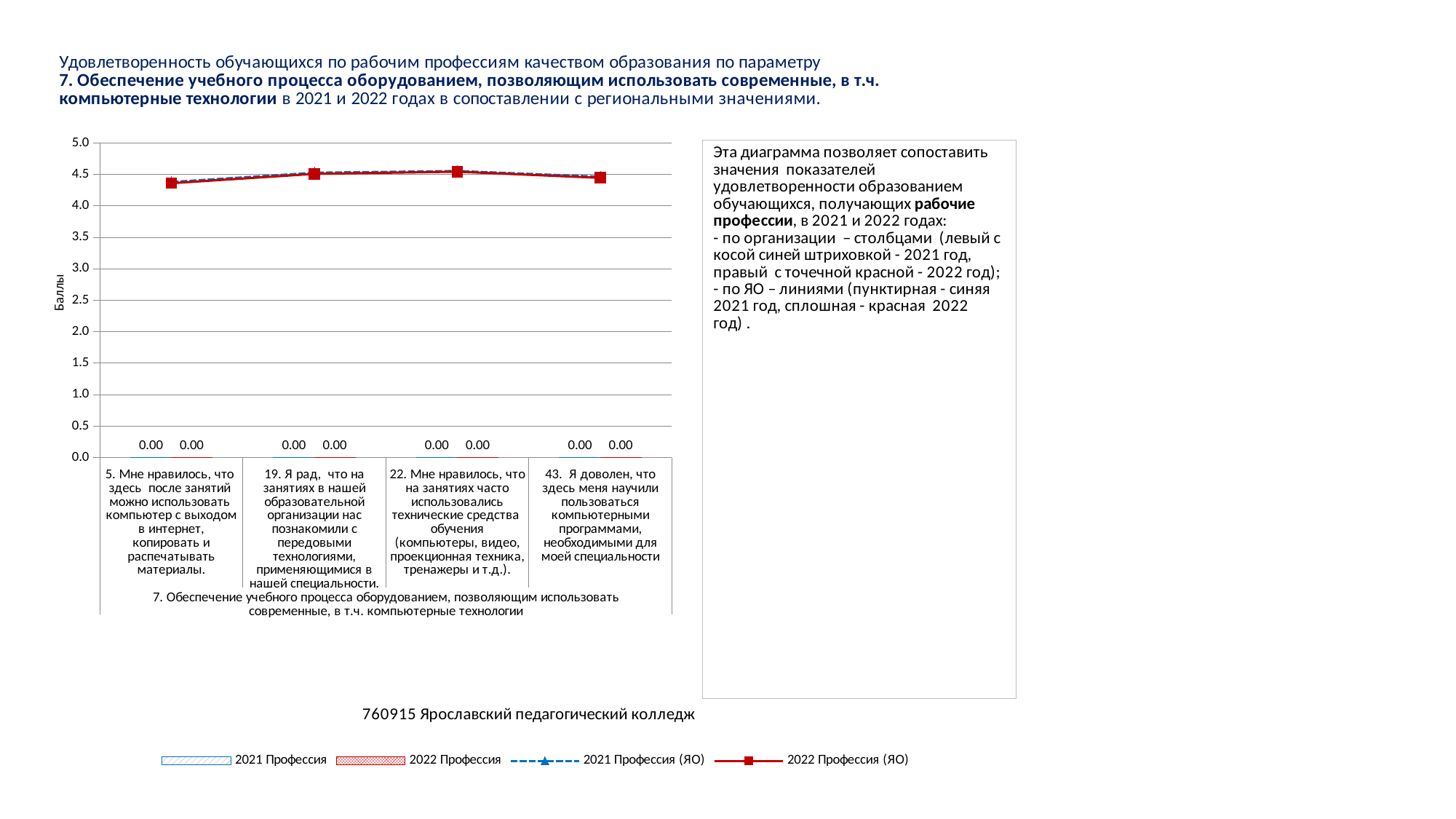
For category 19, which is larger: the '2022 Профессия' bar or the '2022 Профессия (ЯО)' line? 2022 Профессия (ЯО) What is the value of the '2022 Профессия' bar for category 43 (Я доволен, что здесь меня научили пользоваться компьютерными программами...)? 0.00 How many categories (questions) are shown along the x axis of the chart? 4 Is the value of the '2022 Профессия (ЯО)' line for category 43 greater or less than 4.0? greater Is the value of the '2022 Профессия (ЯО)' line for category 22 greater or less than 4.0? greater What is the title of the vertical axis of the chart? Баллы Which legend entry is shown as a solid red line with square markers? 2022 Профессия (ЯО) Is the value of the '2021 Профессия (ЯО)' line for category 5 greater or less than 5.0? less What is the value of the '2021 Профессия' bar for category 5 (Мне нравилось, что здесь после занятий можно использовать компьютер...)? 0.00 What kind of chart is shown on the slide? A combined bar and line chart What is the difference between the '2021 Профессия' and '2022 Профессия' bars for category 19? 0.00 How many series does the chart legend list? 4